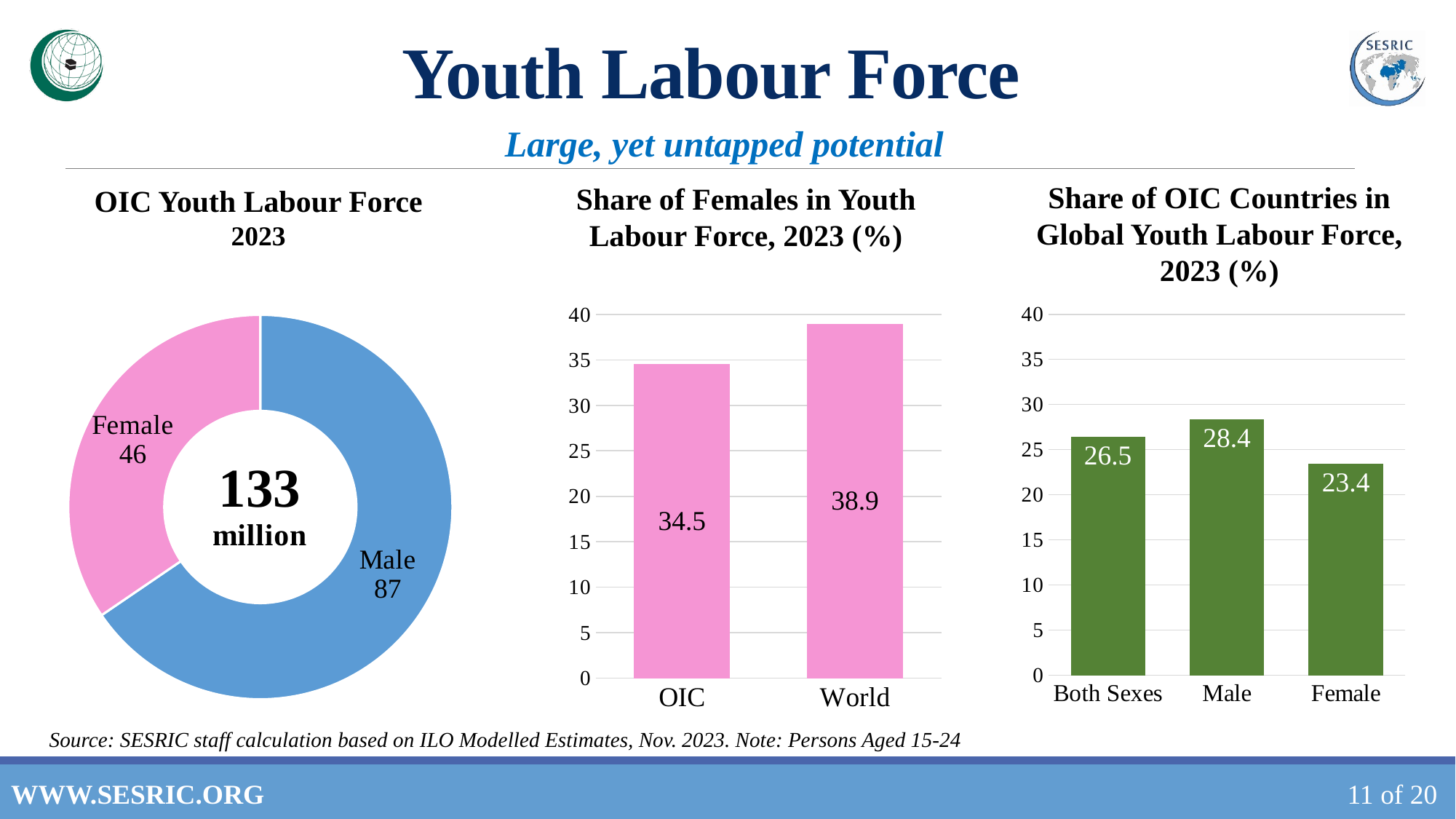
In the 'Share of Females in Youth Labour Force, 2023 (%)' chart, what is the value for World? 38.9 In the 'Share of OIC Countries in Global Youth Labour Force, 2023 (%)' chart, which category has the highest value? Male In the 'OIC Youth Labour Force 2023' chart, what is the value for Female? 46 In the 'OIC Youth Labour Force 2023' chart, which segment is larger, Male or Female? Male In the 'OIC Youth Labour Force 2023' chart, what is the difference between the Male and Female values? 41 How many categories are shown in the 'Share of OIC Countries in Global Youth Labour Force, 2023 (%)' chart? 3 In the 'OIC Youth Labour Force 2023' chart, what total is shown in the centre of the donut? 133 million In the 'OIC Youth Labour Force 2023' chart, what is the value for Male? 87 In the 'Share of OIC Countries in Global Youth Labour Force, 2023 (%)' chart, what is the value for Female? 23.4 What kind of chart is the 'OIC Youth Labour Force 2023' chart? Donut (pie) chart In the 'Share of Females in Youth Labour Force, 2023 (%)' chart, what is the value for OIC? 34.5 In the 'Share of Females in Youth Labour Force, 2023 (%)' chart, what is the difference between the World and OIC values? 4.4